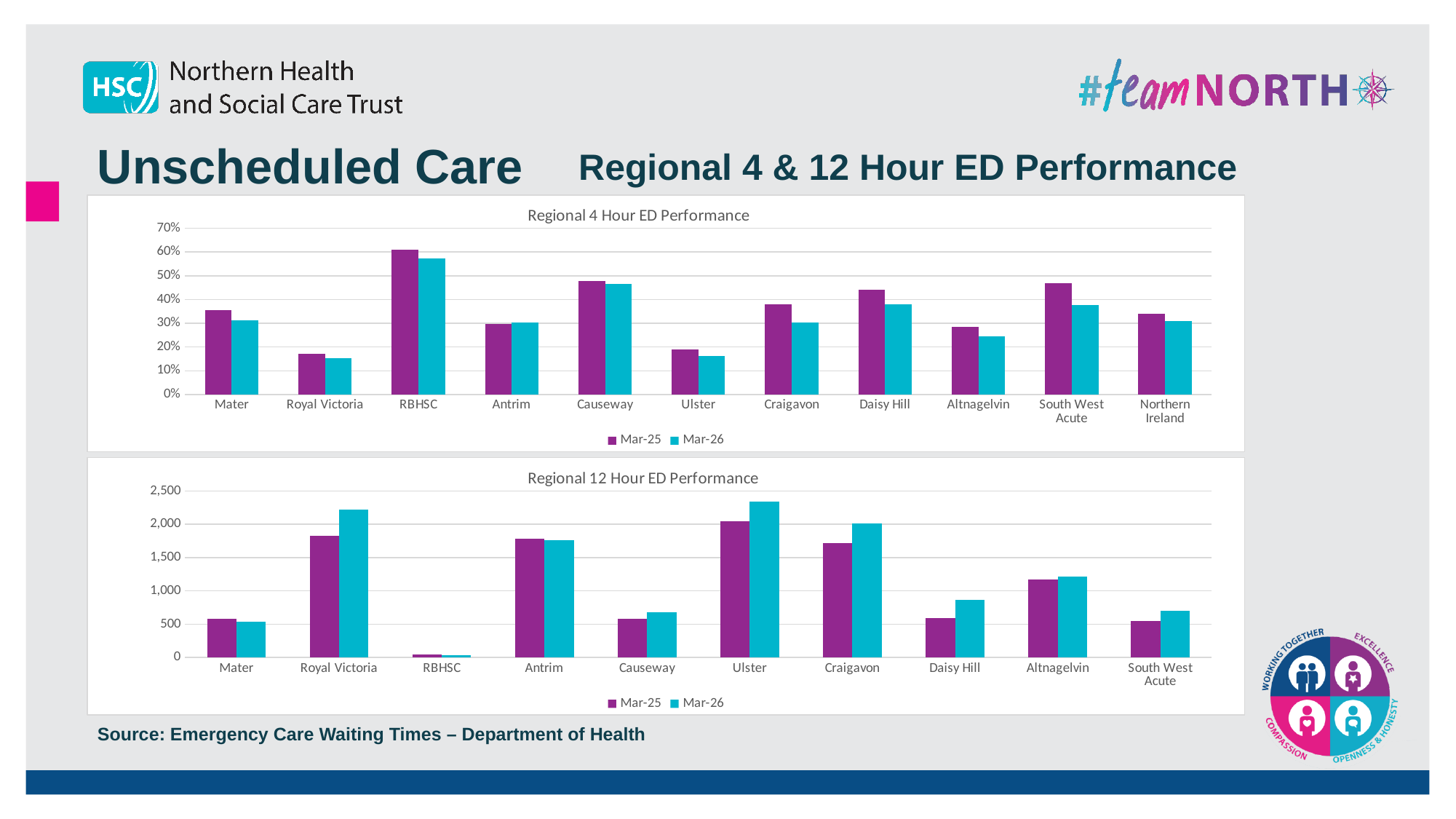
How many categories are shown on the x axis of the Regional 12 Hour ED Performance chart? 10 In the Regional 4 Hour ED Performance chart, which is larger for Daisy Hill, the Mar-25 value or the Mar-26 value? Mar-25 What type of chart is the Regional 4 Hour ED Performance chart? Bar chart In the Regional 4 Hour ED Performance chart, is the Mar-25 value for RBHSC greater or less than 50%? greater In the Regional 12 Hour ED Performance chart, which category has the highest Mar-26 value? Ulster How many series does the legend of the Regional 12 Hour ED Performance chart list? 2 In the Regional 12 Hour ED Performance chart, which is larger for Royal Victoria, the Mar-25 value or the Mar-26 value? Mar-26 In the Regional 4 Hour ED Performance chart, which category has the lowest Mar-26 value? Royal Victoria How many categories are shown on the x axis of the Regional 4 Hour ED Performance chart? 11 In the Regional 12 Hour ED Performance chart, which category has the lowest Mar-25 value? RBHSC In the Regional 12 Hour ED Performance chart, is the Mar-26 value for Royal Victoria greater or less than 2,000? greater In the Regional 4 Hour ED Performance chart, which category has the highest Mar-25 value? RBHSC